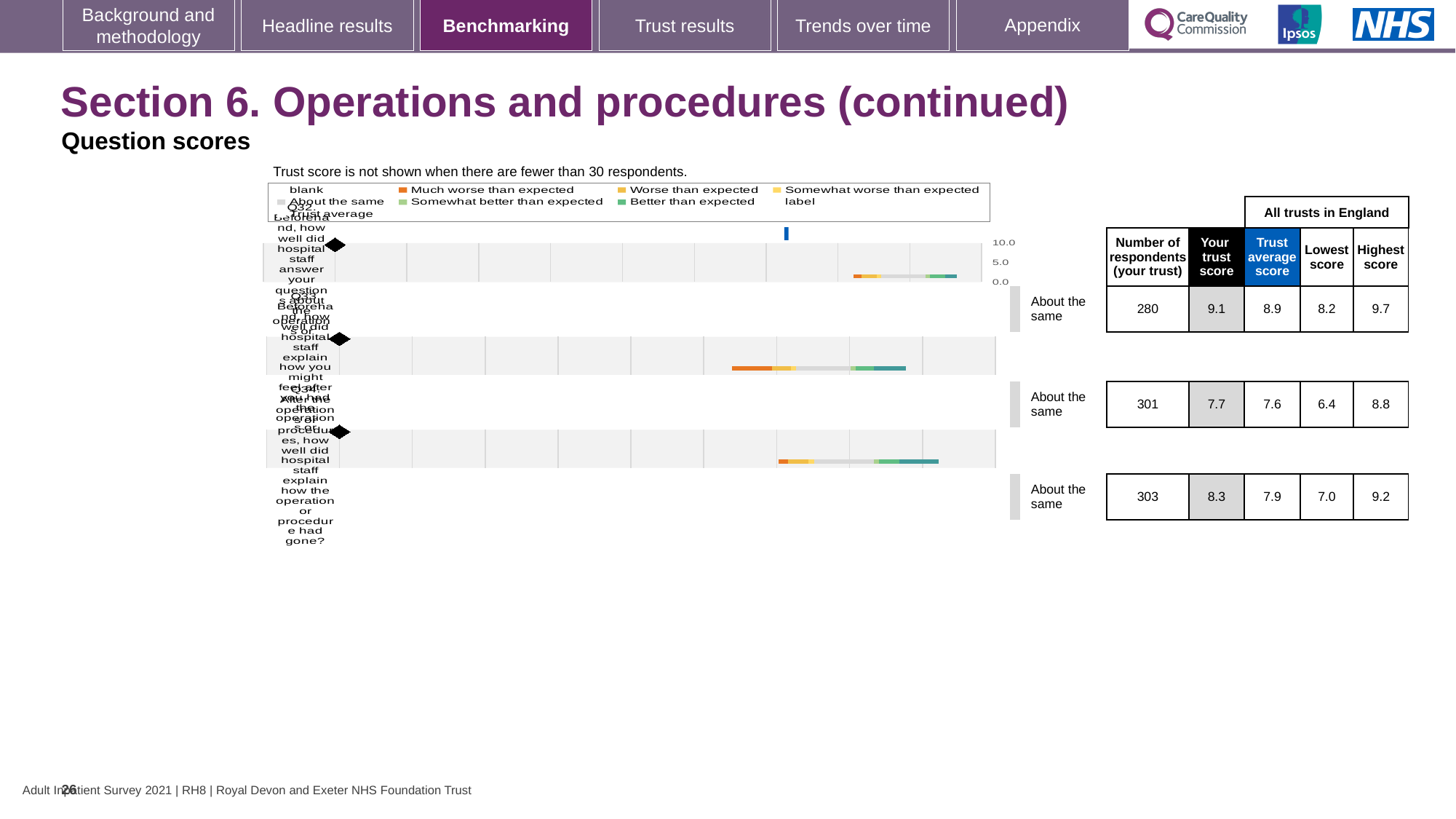
Which of the three question charts has the lowest 'Your trust score'? Q33 (middle chart) How many question charts are shown on the slide? 3 For the middle chart (Q33), what is the lowest score among all trusts in England? 6.4 For the bottom chart (Q34), what is the difference between your trust score and the trust average score? 0.4 Which of the three question charts has the highest 'Your trust score'? Q32 (top chart) For the top chart (Q32), is your trust score larger or smaller than the trust average score? larger For the middle chart (Q33), what is the trust average score? 7.6 For the top chart (Q32), what is the trust score shown in the 'Your trust score' column? 9.1 What kind of chart is used to show the benchmarking results for each question on this slide? bar chart What benchmark category is shown next to each of the three charts? About the same For the bottom chart (Q34), what is the highest score among all trusts in England? 9.2 For the top chart (Q32), what is the number of respondents for your trust? 280